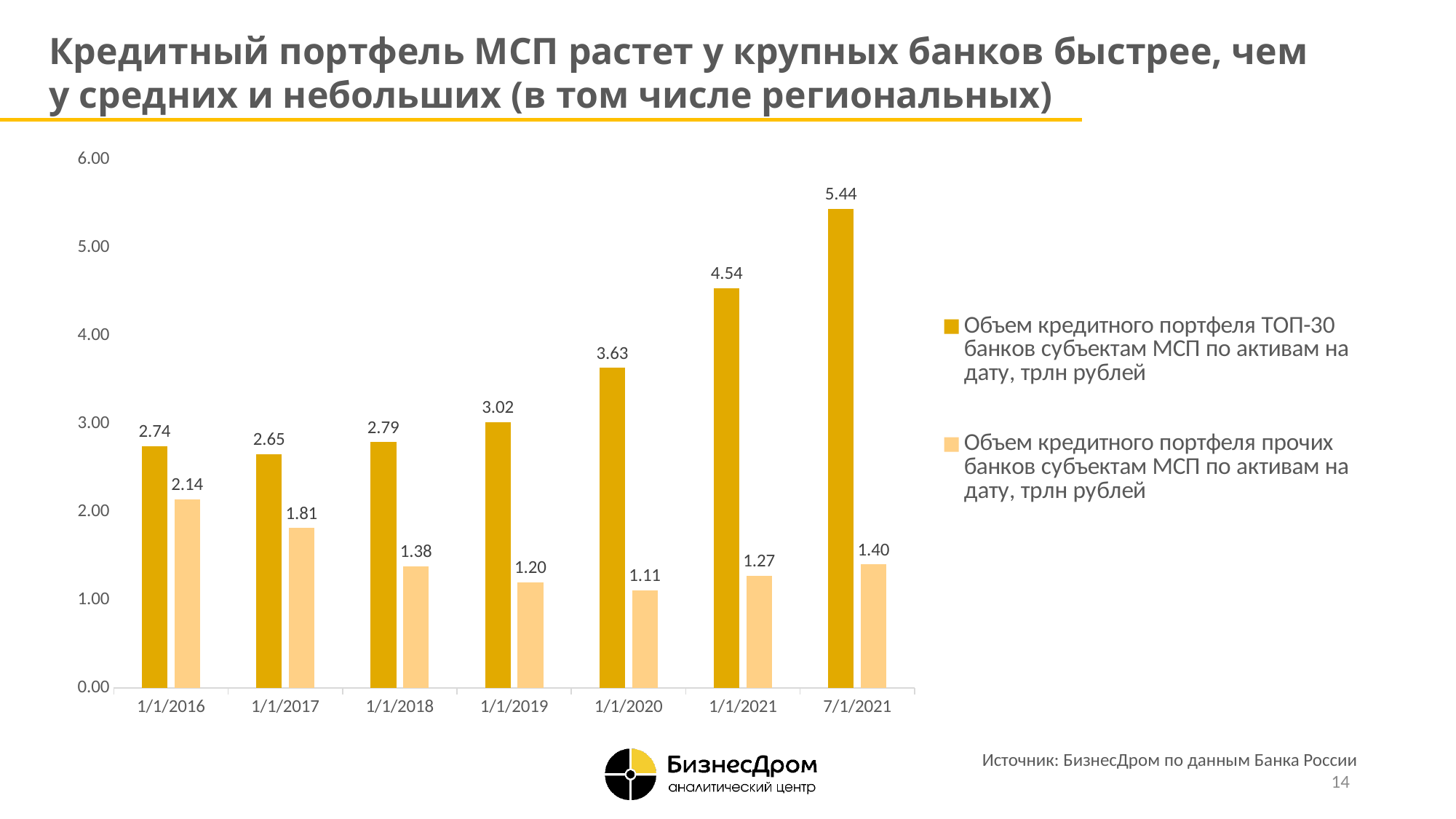
On which date is the value for the other banks series lowest? 1/1/2020 What kind of chart is shown on the slide? Bar chart What is the value for the other banks series (Объем кредитного портфеля прочих банков) on 1/1/2016? 2.14 What is the value for the TOP-30 banks series on 1/1/2019? 3.02 Does the TOP-30 banks series rise or fall from 1/1/2017 to 7/1/2021? Rises What is the value for the TOP-30 banks series (Объем кредитного портфеля ТОП-30 банков) on 7/1/2021? 5.44 How many dates are shown on the x axis? 7 Which is larger on 1/1/2017: the TOP-30 banks value or the other banks value? TOP-30 banks (2.65) Is the value for the TOP-30 banks series on 1/1/2021 greater or less than 4.00? greater What is the difference between the TOP-30 banks value and the other banks value on 7/1/2021? 4.04 On which date is the value for the TOP-30 banks series highest? 7/1/2021 How many series does the legend list? 2